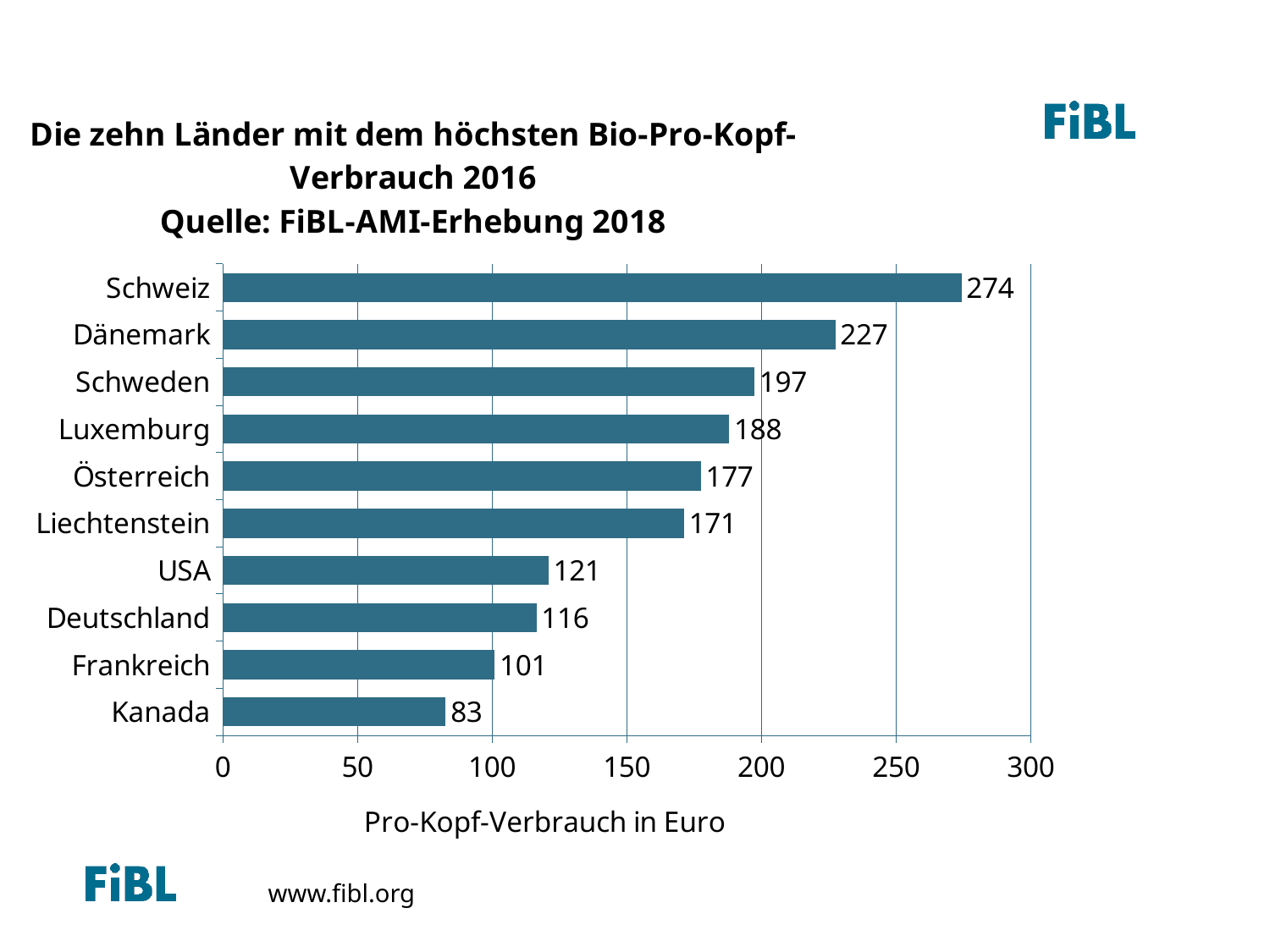
Which country has the lowest per-capita consumption in the chart? Kanada What is the difference between the values for USA and Frankreich? 20 Is the value for Schweden greater or less than 150? greater What value is shown for Deutschland? 116 What is the label of the horizontal axis? Pro-Kopf-Verbrauch in Euro What value is shown for Liechtenstein? 171 What is the per-capita organic consumption value shown for Schweiz? 274 What is the difference between the values for Dänemark and Schweden? 30 Which country has the highest per-capita consumption in the chart? Schweiz Which has a larger value, Luxemburg or Österreich? Luxemburg How many countries are shown in the chart? 10 What kind of chart is shown on the slide? Bar chart